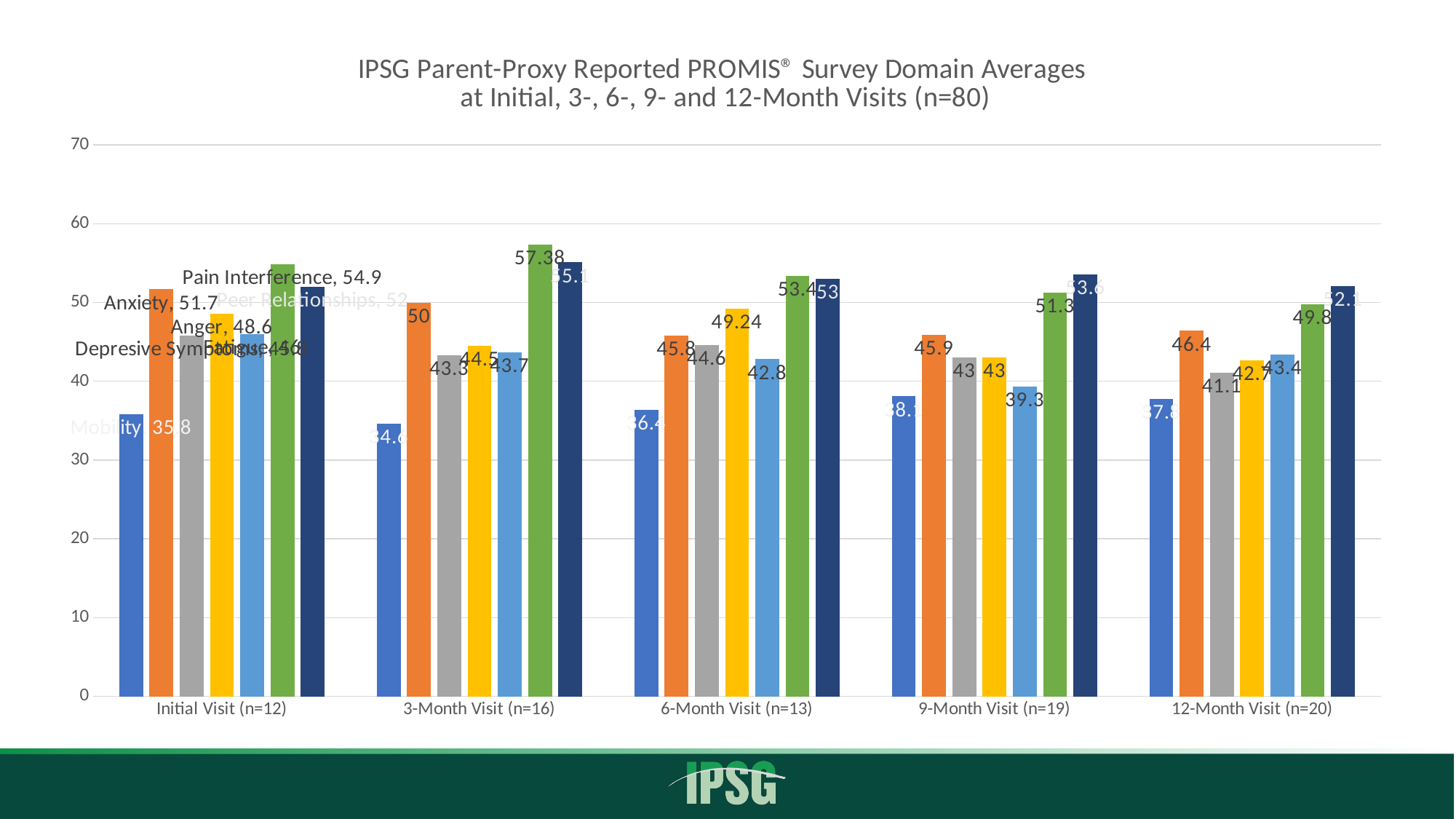
How many visit categories are shown along the x axis? 5 What is the Pain Interference average at the 3-Month Visit? 57.38 What is the Peer Relationships average at the 9-Month Visit? 53.6 What is the Anxiety average at the Initial Visit? 51.7 At which visit is the Mobility average lowest? 3-Month Visit (n=16) Which domain has the highest average at the 3-Month Visit? Pain Interference How many bars are plotted for each visit group? 7 Does the Pain Interference average rise or fall from the 3-Month Visit to the 12-Month Visit? fall What kind of chart is shown on the slide? Bar chart Is the Mobility average at the Initial Visit greater or less than 40? less What is the difference between the Anxiety average at the Initial Visit and at the 12-Month Visit? 5.3 Is the Anger average larger at the 6-Month Visit or the 9-Month Visit? 6-Month Visit